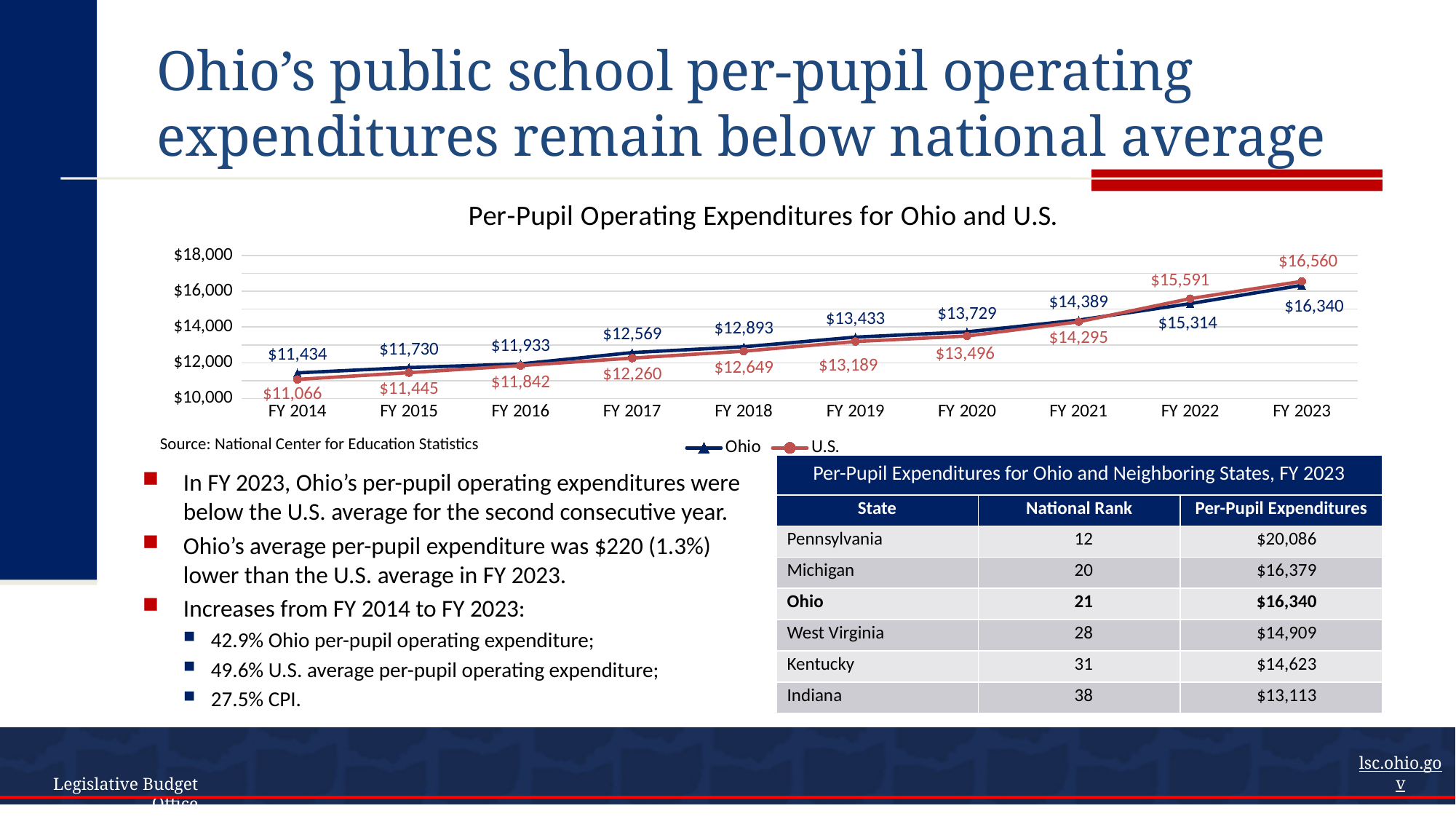
In which fiscal year is the Ohio series highest? FY 2023 How many series does the legend list? 2 What kind of chart is shown? Line chart What is the Ohio per-pupil operating expenditure for FY 2014? $11,434 What is the U.S. value for FY 2017? $12,260 Does the Ohio series rise or fall from FY 2014 to FY 2023? Rise What is the Ohio value for FY 2019? $13,433 What is the U.S. per-pupil operating expenditure for FY 2023? $16,560 In which fiscal year is the U.S. series lowest? FY 2014 Which is larger in FY 2020, the Ohio value or the U.S. value? Ohio How many fiscal years are plotted on the x axis? 10 What is the difference between the U.S. and Ohio values in FY 2023? $220